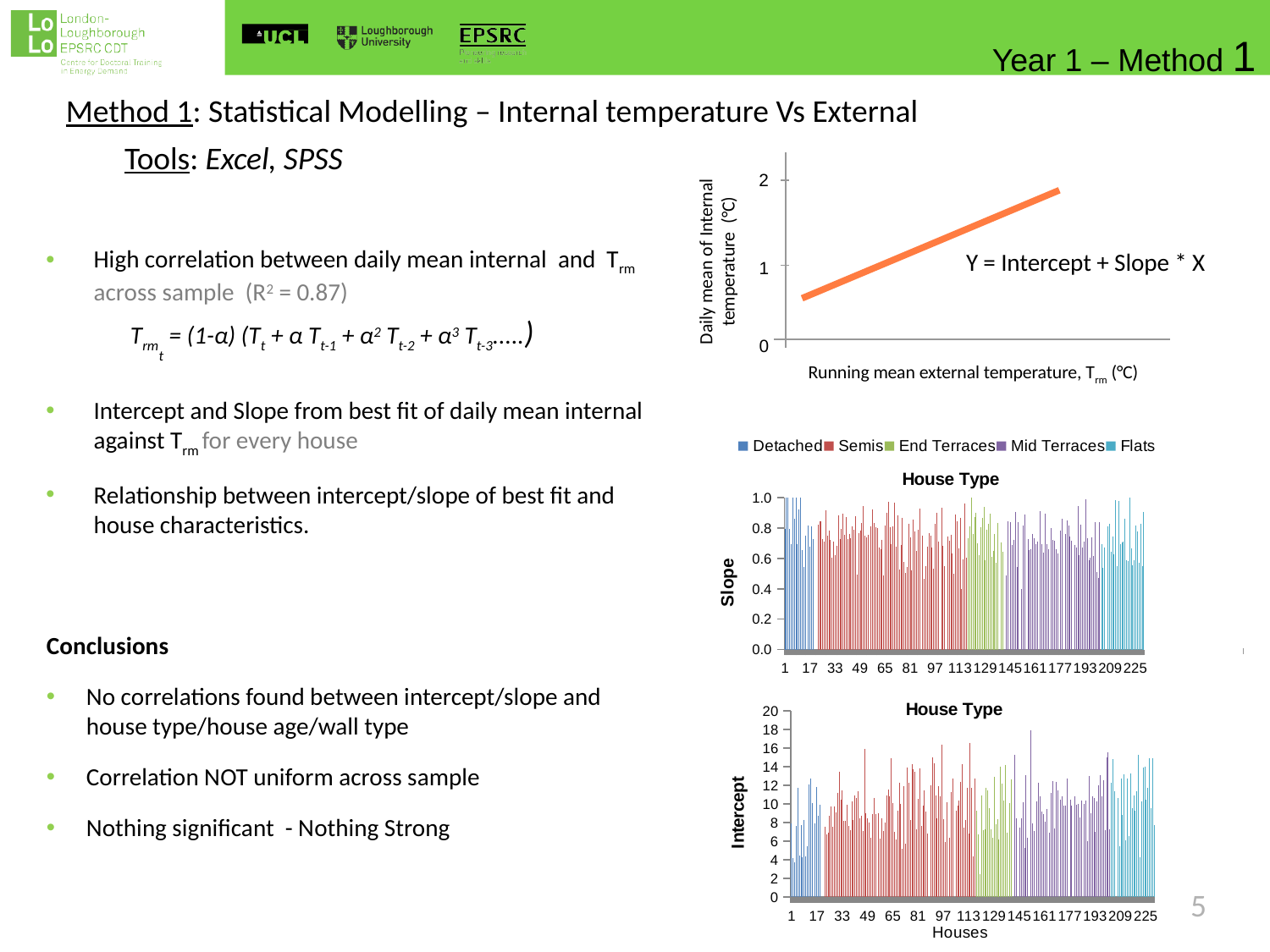
What is the label of the horizontal axis on the bottom-right chart? Houses What is the highest tick value shown on the vertical axis of the bottom-right 'House Type' chart? 20 What kind of chart is the middle chart titled 'House Type' with the Slope axis? bar chart What is the label of the vertical axis on the bottom-right chart? Intercept In the top-right chart, does the plotted line rise or fall as the running mean external temperature increases? rises What kind of chart is the top-right chart showing daily mean internal temperature against running mean external temperature? line chart How many series does the legend above the 'House Type' charts list? 5